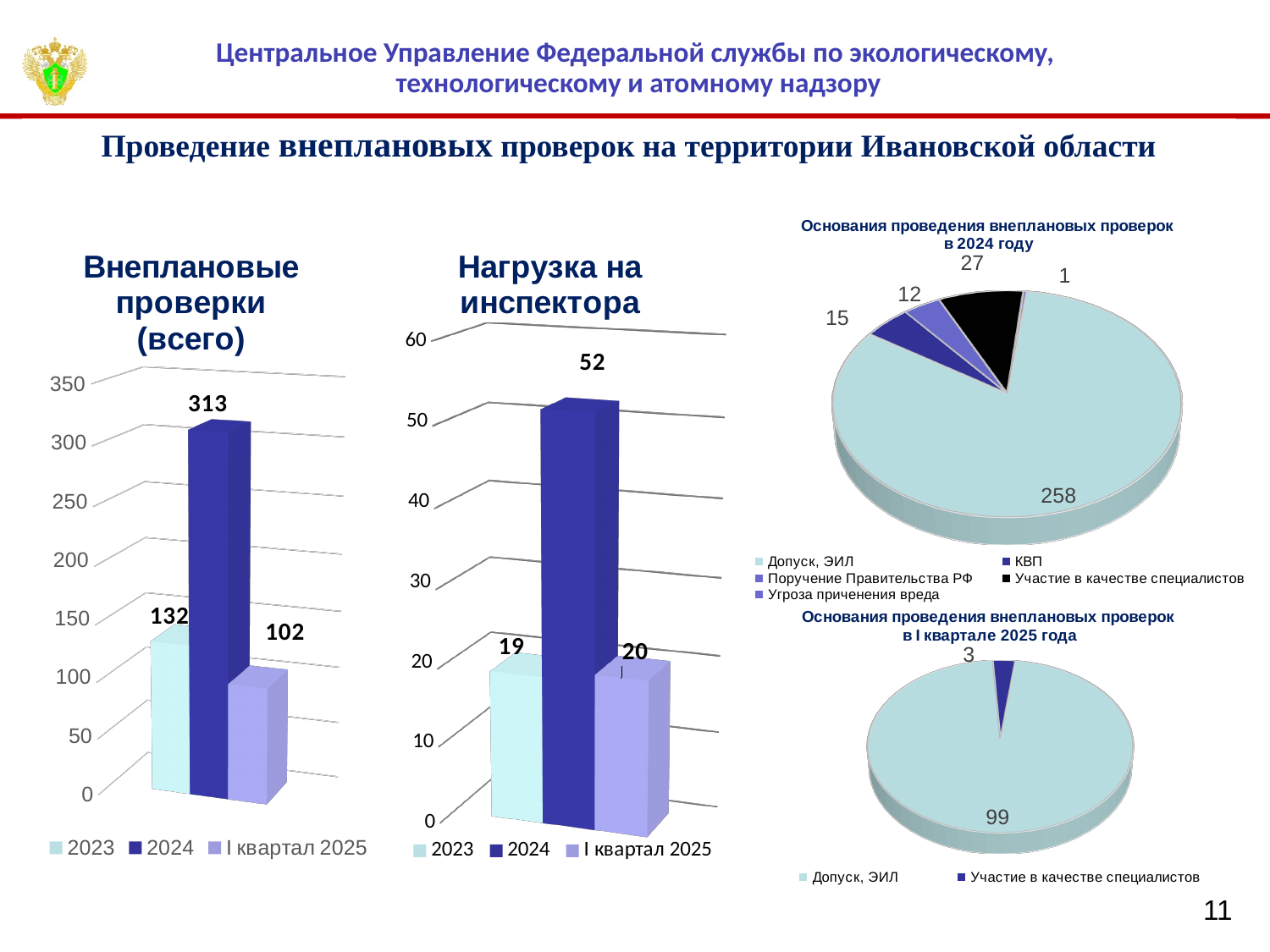
In the chart titled "Внеплановые проверки (всего)", what is the value for 2024? 313 How many categories does the legend of the pie chart titled "Основания проведения внеплановых проверок в 2024 году" list? 5 In the pie chart titled "Основания проведения внеплановых проверок в 2024 году", what is the value for Участие в качестве специалистов (the black slice)? 27 How many series does the legend of the chart titled "Нагрузка на инспектора" list? 3 In the chart titled "Нагрузка на инспектора", which is larger: the value for 2023 or for I квартал 2025? I квартал 2025 In the pie chart titled "Основания проведения внеплановых проверок в I квартале 2025 года", what is the value for Допуск, ЭИЛ? 99 What kind of chart is "Внеплановые проверки (всего)"? bar chart In the chart titled "Нагрузка на инспектора", what is the value for 2023? 19 In the chart titled "Внеплановые проверки (всего)", what is the difference between the 2024 and 2023 values? 181 In the pie chart titled "Основания проведения внеплановых проверок в 2024 году", what is the value of the largest slice? 258 In the chart titled "Нагрузка на инспектора", which year has the highest value? 2024 In the chart titled "Внеплановые проверки (всего)", what is the value for I квартал 2025? 102